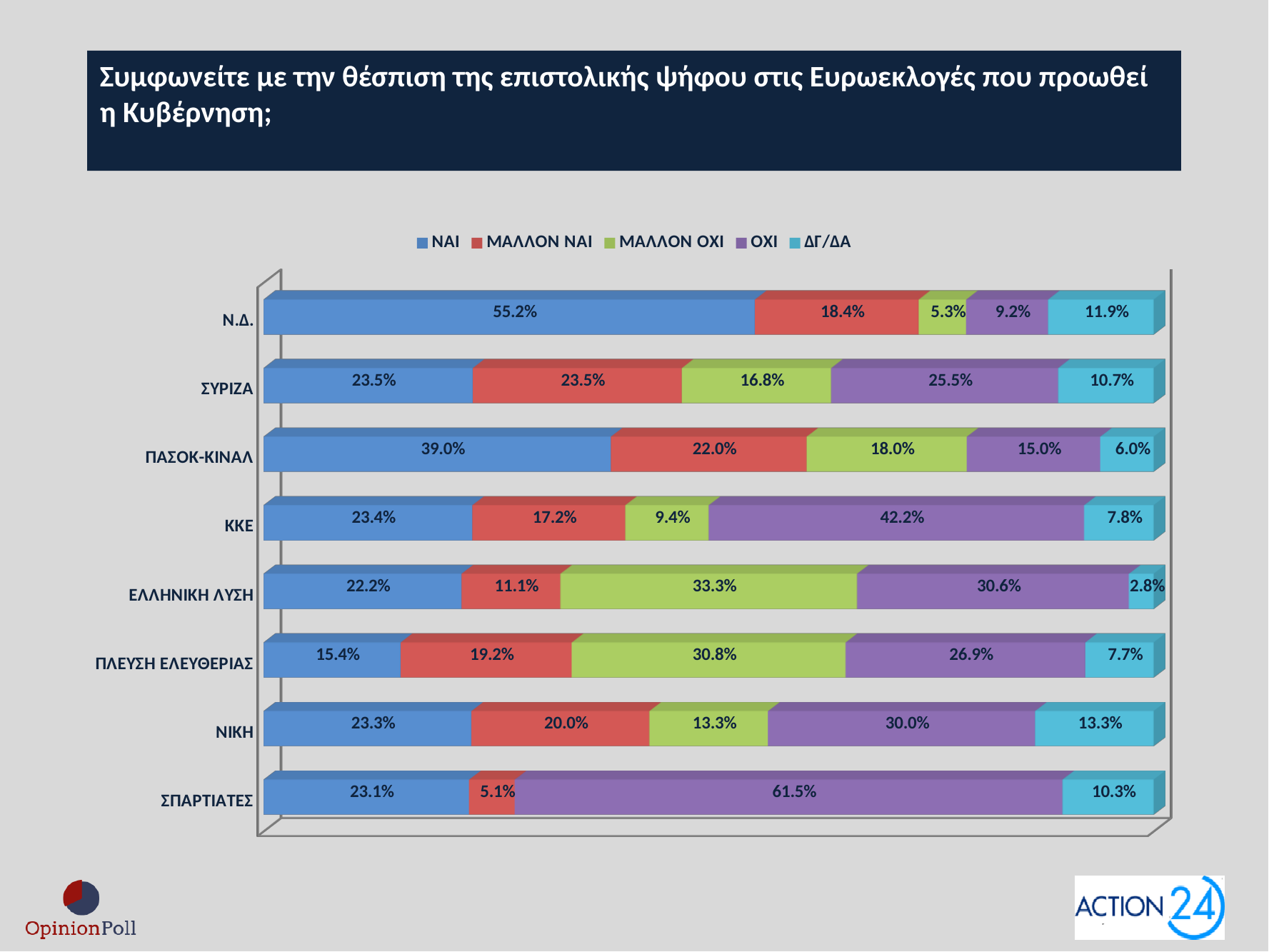
How many series does the legend list? 5 What is the ΔΓ/ΔΑ value for ΠΑΣΟΚ-ΚΙΝΑΛ? 6.0% What is the difference between the ΝΑΙ value for Ν.Δ. and the ΝΑΙ value for ΣΥΡΙΖΑ? 31.7 percentage points What is the ΝΑΙ value for Ν.Δ.? 55.2% How many parties are shown on the chart? 8 Which party has the lowest ΝΑΙ value? ΠΛΕΥΣΗ ΕΛΕΥΘΕΡΙΑΣ Which party has the highest ΟΧΙ value? ΣΠΑΡΤΙΑΤΕΣ What kind of chart is shown on the slide? Stacked bar chart What is the ΟΧΙ value for ΚΚΕ? 42.2% Which is larger: the ΟΧΙ value for ΚΚΕ or the ΟΧΙ value for ΕΛΛΗΝΙΚΗ ΛΥΣΗ? ΚΚΕ Which party has the lowest ΔΓ/ΔΑ value? ΕΛΛΗΝΙΚΗ ΛΥΣΗ Which party has the highest ΝΑΙ value? Ν.Δ.